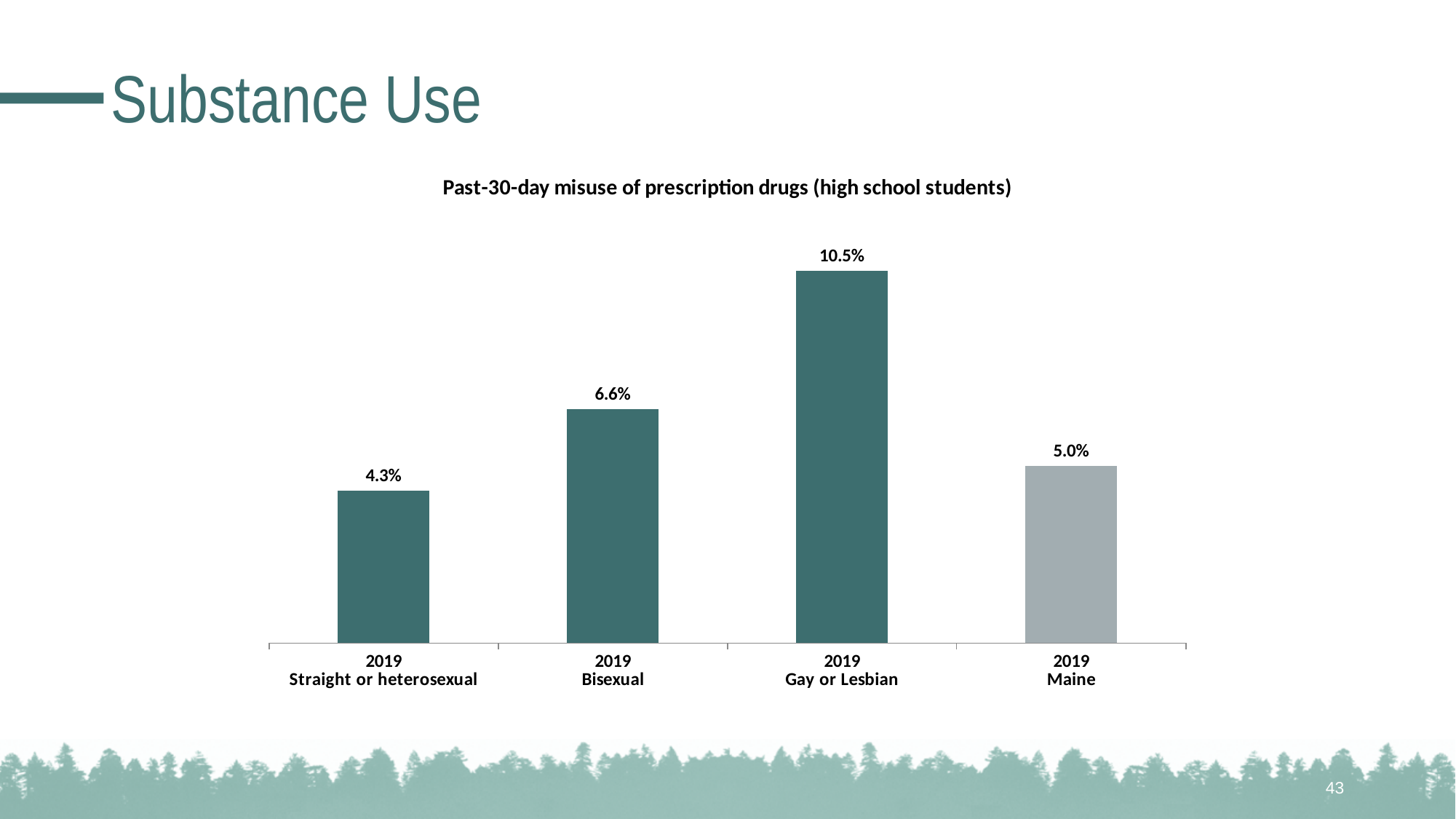
What is the title of the chart? Past-30-day misuse of prescription drugs (high school students) Which category has the lowest value? Straight or heterosexual What is the value for Straight or heterosexual students? 4.3% How many bars are shown in the chart? 4 Which category has the highest value? Gay or Lesbian What is the value for Maine? 5.0% What is the value for Bisexual students? 6.6% What is the difference between the Maine value and the Straight or heterosexual value? 0.7% Which is larger, the value for Bisexual or the value for Maine? Bisexual What is the difference between the Gay or Lesbian value and the Bisexual value? 3.9% What kind of chart is shown on the slide? Bar chart What is the value for Gay or Lesbian students in the chart? 10.5%